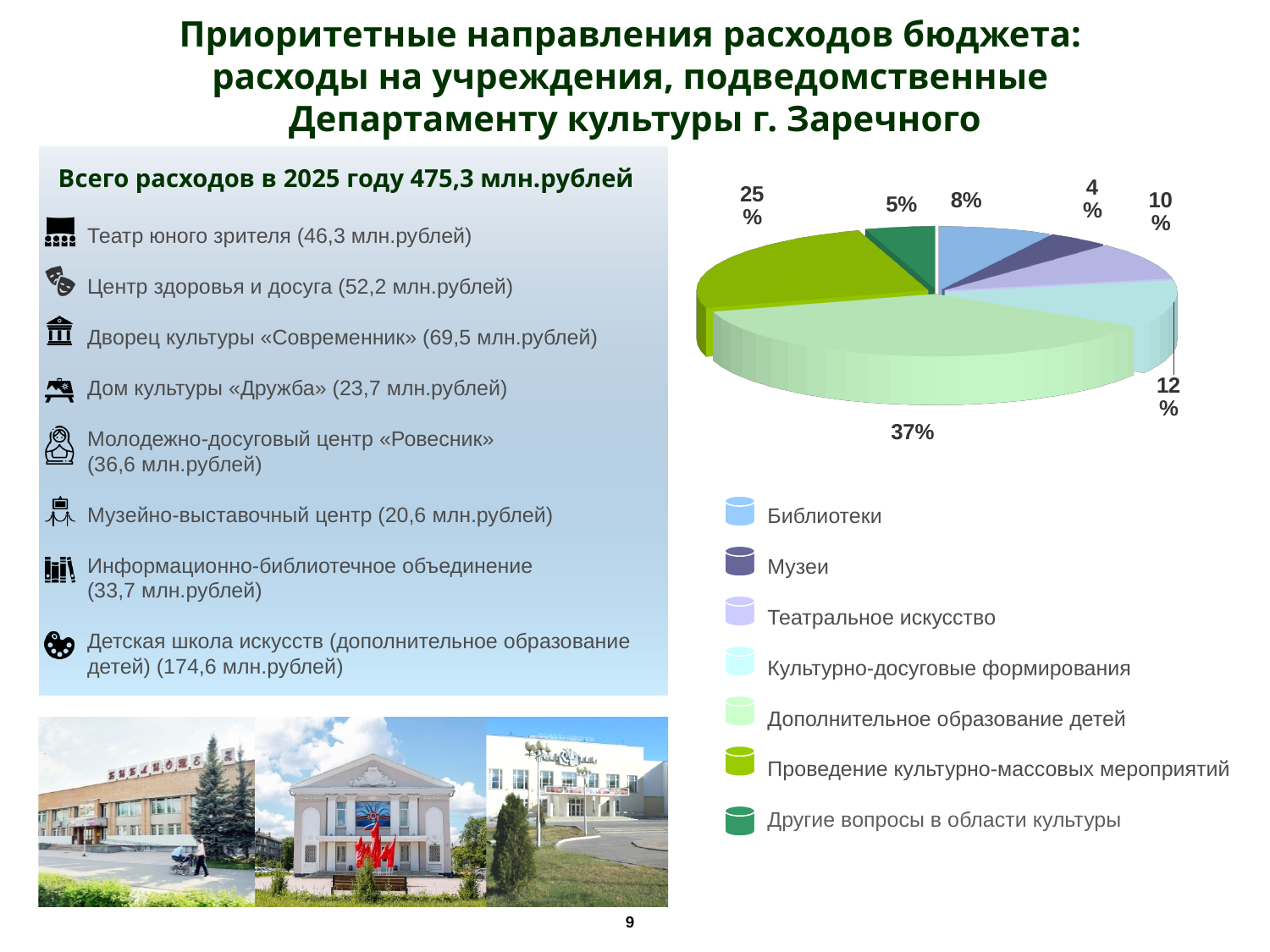
What share of the pie chart is labelled for Музеи? 4% What is the total expenditure for 2025 stated on the slide? 475,3 млн.рублей What share of the pie chart is labelled for Библиотеки? 8% What share of the pie chart is labelled for Проведение культурно-массовых мероприятий? 25% What kind of chart is shown on the slide? pie chart How many categories does the legend of the pie chart list? 7 What share of the pie chart is labelled for Дополнительное образование детей? 37% What share of the pie chart is labelled for Культурно-досуговые формирования? 12% What is the difference in percentage points between the slices for Дополнительное образование детей and Проведение культурно-массовых мероприятий? 12 Which slice is larger: Театральное искусство or Другие вопросы в области культуры? Театральное искусство Which category has the largest slice of the pie chart? Дополнительное образование детей Which category has the smallest slice of the pie chart? Музеи